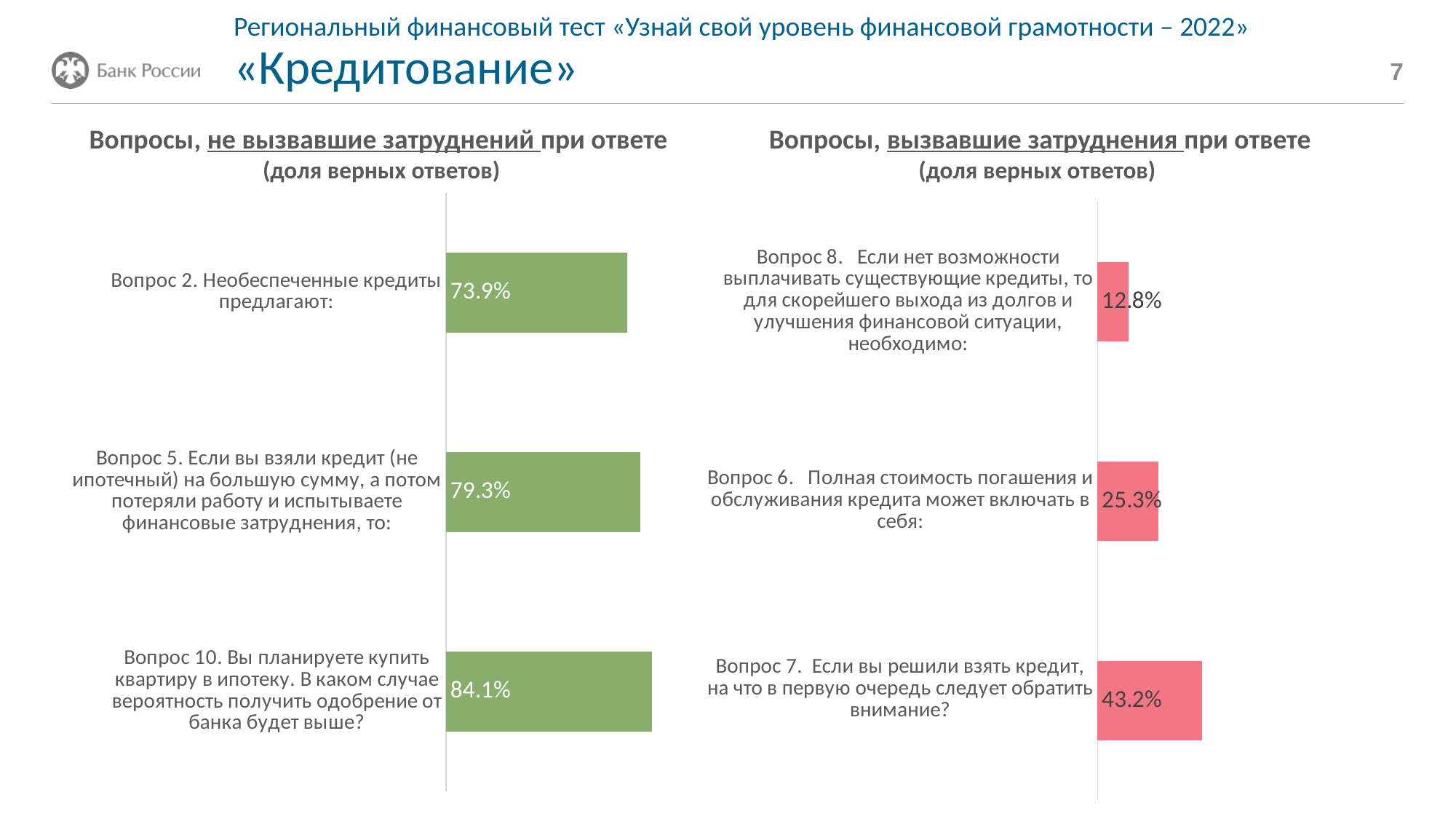
In the right chart (Вопросы, вызвавшие затруднения при ответе), what is the value for Вопрос 6? 25.3% What colour are the bars in the right chart (Вопросы, вызвавшие затруднения при ответе)? Red (pink) In the left chart (Вопросы, не вызвавшие затруднений при ответе), which question has the highest share of correct answers? Вопрос 10 In the right chart (Вопросы, вызвавшие затруднения при ответе), what is the difference between the values for Вопрос 7 and Вопрос 8? 30.4% In the left chart (Вопросы, не вызвавшие затруднений при ответе), what is the share of correct answers for Вопрос 2? 73.9% In the right chart (Вопросы, вызвавшие затруднения при ответе), which question has the lowest share of correct answers? Вопрос 8 What type of chart is the right chart (Вопросы, вызвавшие затруднения при ответе)? Bar chart How many questions (bars) are shown in the left chart (Вопросы, не вызвавшие затруднений при ответе)? 3 In the right chart (Вопросы, вызвавшие затруднения при ответе), which has a larger value: Вопрос 6 or Вопрос 7? Вопрос 7 In the right chart (Вопросы, вызвавшие затруднения при ответе), what is the share of correct answers for Вопрос 8? 12.8% In the left chart (Вопросы, не вызвавшие затруднений при ответе), what is the value for Вопрос 10? 84.1% In the left chart (Вопросы, не вызвавшие затруднений при ответе), what is the difference between the values for Вопрос 10 and Вопрос 2? 10.2%